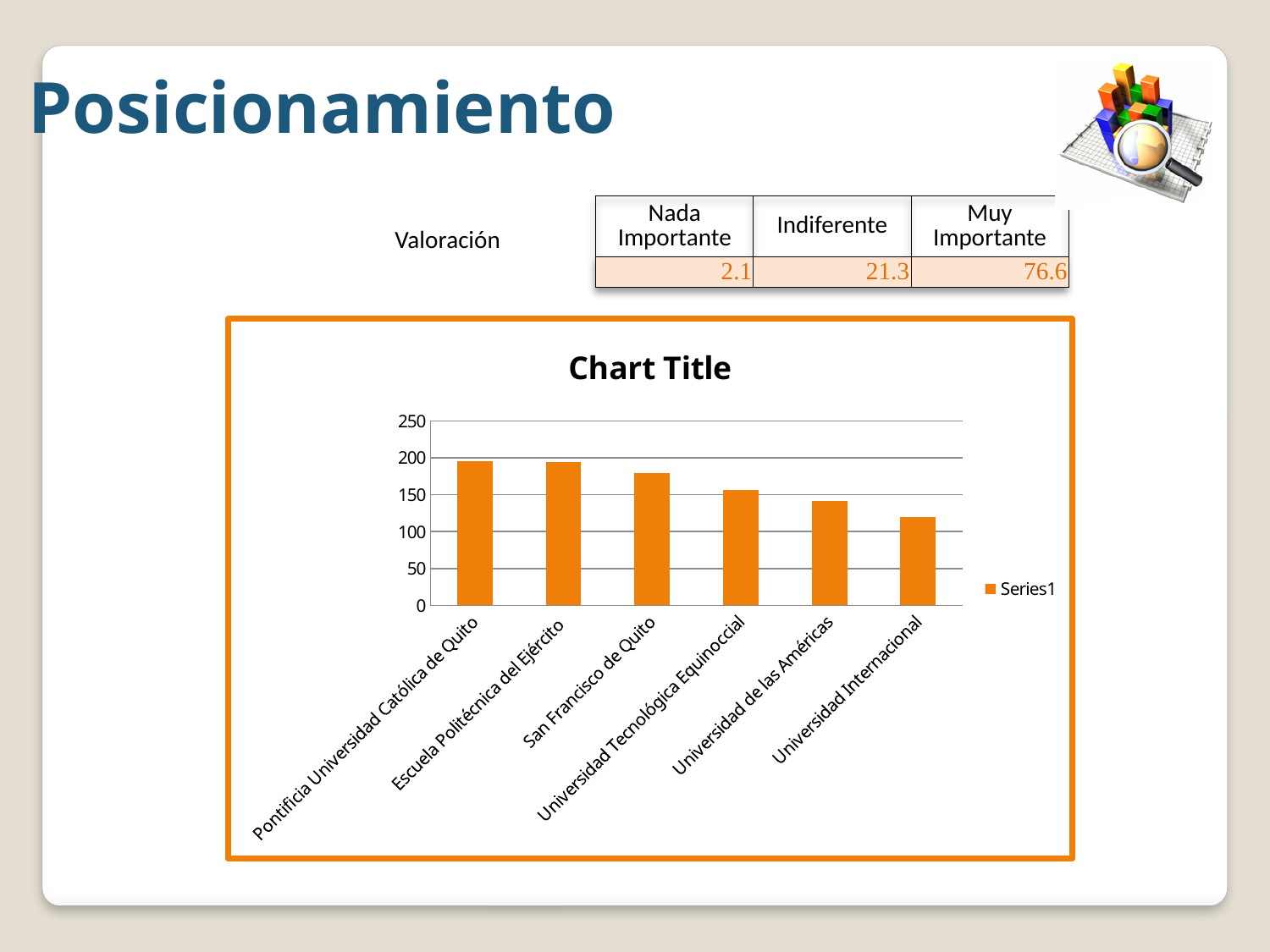
Which university has the lowest bar in the chart? Universidad Internacional Do the bar values rise or fall from left to right along the x axis? fall Is the value for Universidad Internacional greater or less than 150? less How many universities are shown on the x axis of the chart? 6 What kind of chart is shown on the slide? bar chart Which has the larger value, San Francisco de Quito or Universidad Internacional? San Francisco de Quito What is the name of the series shown in the chart legend? Series1 How many series does the chart legend list? 1 Is the value for San Francisco de Quito greater or less than 200? less Which has the larger value, Universidad Tecnológica Equinoccial or Universidad de las Américas? Universidad Tecnológica Equinoccial Is the value for Universidad Tecnológica Equinoccial greater or less than 100? greater